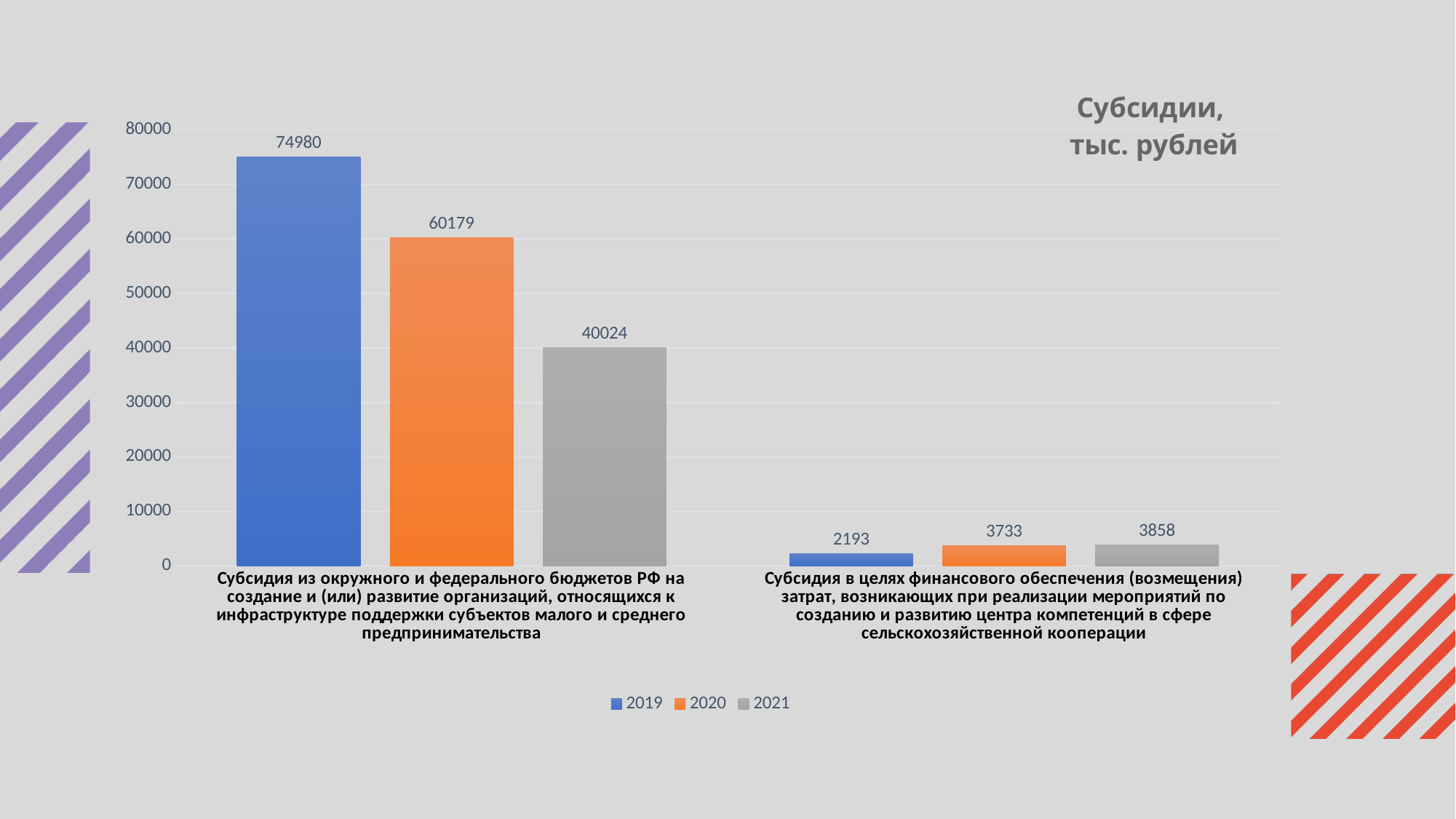
What is the 2020 value for the first category (SME support infrastructure subsidy)? 60179 Which is larger: the 2020 value for the first category or the 2021 value for the first category? 2020 What is the title of the chart? Субсидии, тыс. рублей What kind of chart is shown on the slide? Bar chart What is the 2021 value for the subsidy for the agricultural cooperation competence centre (the second category)? 3858 What is the difference between the 2019 and 2021 values for the first category (SME support infrastructure subsidy)? 34956 Which year has the lowest value for the second category (agricultural cooperation competence centre subsidy)? 2019 How many categories are shown on the x axis? 2 What is the 2019 value for the subsidy for creating and developing SME support infrastructure organisations (the first category)? 74980 How many series does the legend list? 3 Which year has the highest value for the first category (SME support infrastructure subsidy)? 2019 What is the difference between the 2020 and 2019 values for the second category (agricultural cooperation competence centre subsidy)? 1540